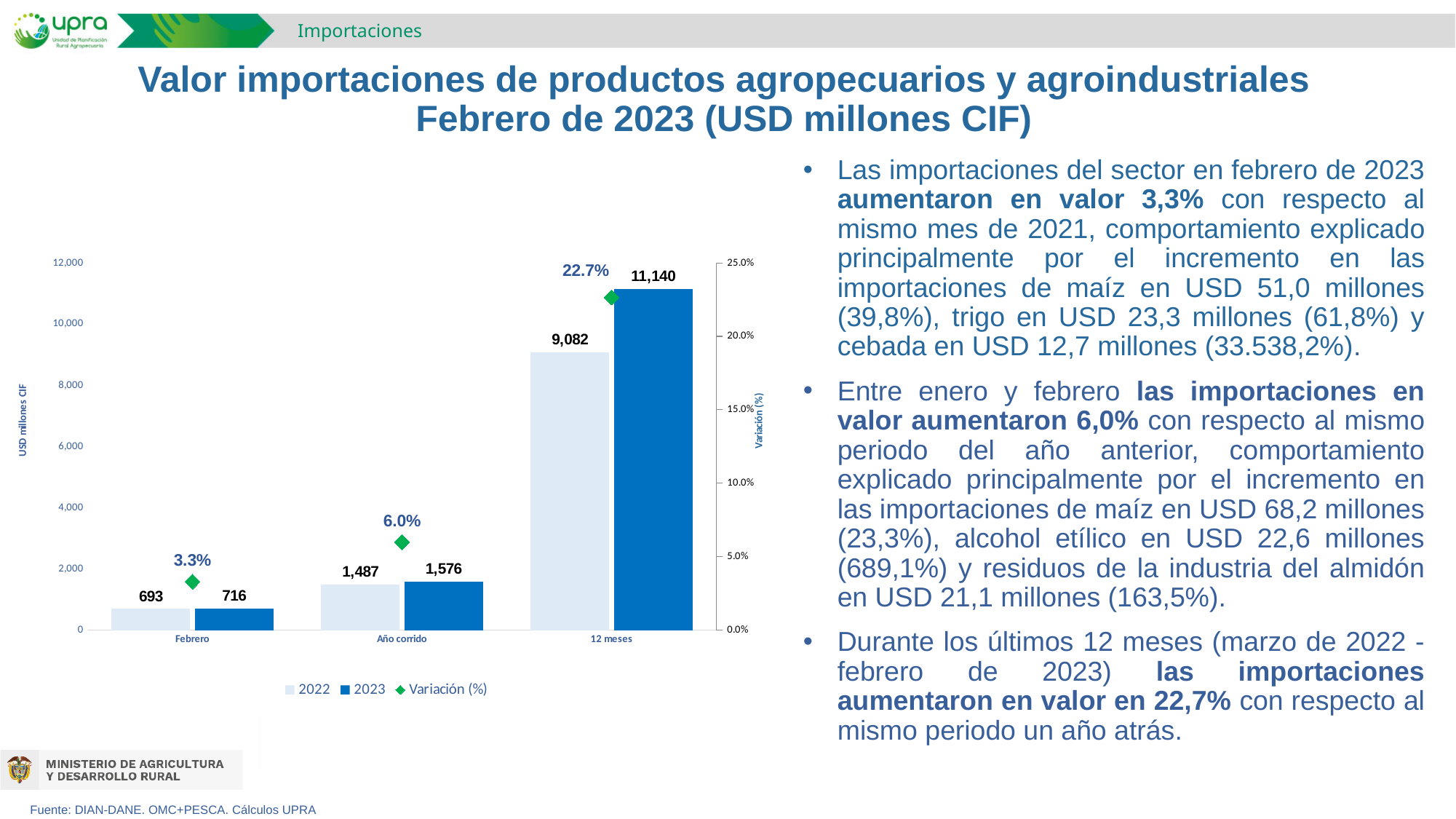
What is the difference between the 2023 and 2022 values for 12 meses? 2,058 What kind of chart is shown on the slide? Bar chart How many categories are shown on the x axis? 3 What is the 2022 value for 12 meses? 9,082 Which category has the highest 2023 value? 12 meses Which is larger for Febrero, the 2022 value or the 2023 value? 2023 What is the 2023 value for Febrero? 716 Which category has the lowest 2022 value? Febrero How many series does the legend list? 3 Do the Variación (%) values rise or fall from Febrero to 12 meses? Rise What is the difference between the 2023 and 2022 values for Año corrido? 89 What is the Variación (%) value shown for Año corrido? 6.0%